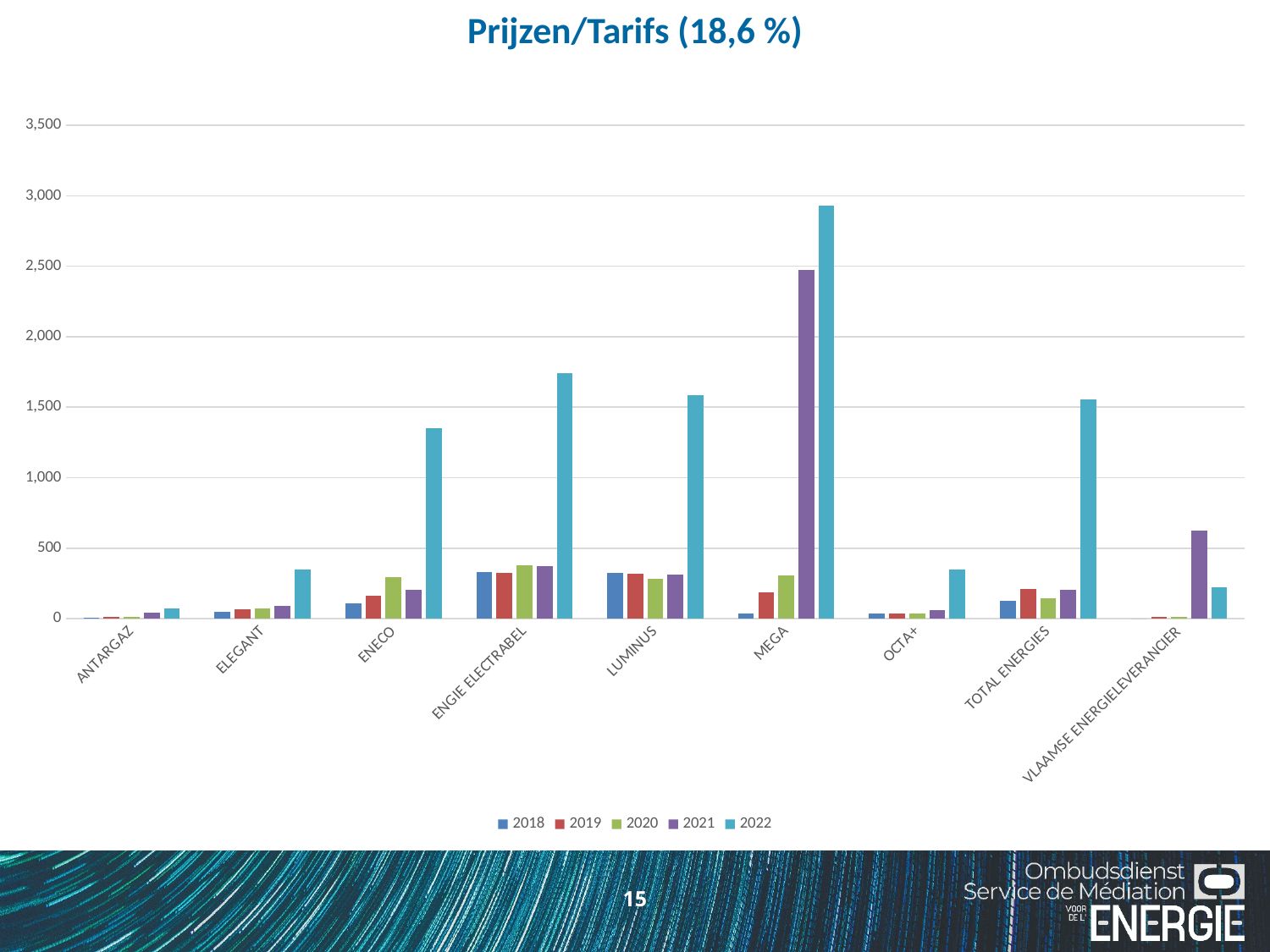
How many series does the legend list? 5 What is the title of the chart? Prijzen/Tarifs (18,6 %) Which is larger: the 2021 value for MEGA or the 2022 value for ENGIE ELECTRABEL? 2021 value for MEGA Is the 2021 value for VLAAMSE ENERGIELEVERANCIER greater or less than 500? greater Is the 2022 value for ENGIE ELECTRABEL greater or less than 1,500? greater What kind of chart is shown on the slide? bar chart For MEGA, do the values rise or fall from 2018 to 2022? rise How many supplier categories are shown on the x axis? 9 Which category has the highest value for 2022? MEGA Which is larger: the 2022 value for LUMINUS or the 2022 value for ENECO? 2022 value for LUMINUS Is the 2022 value for MEGA greater or less than 2,500? greater